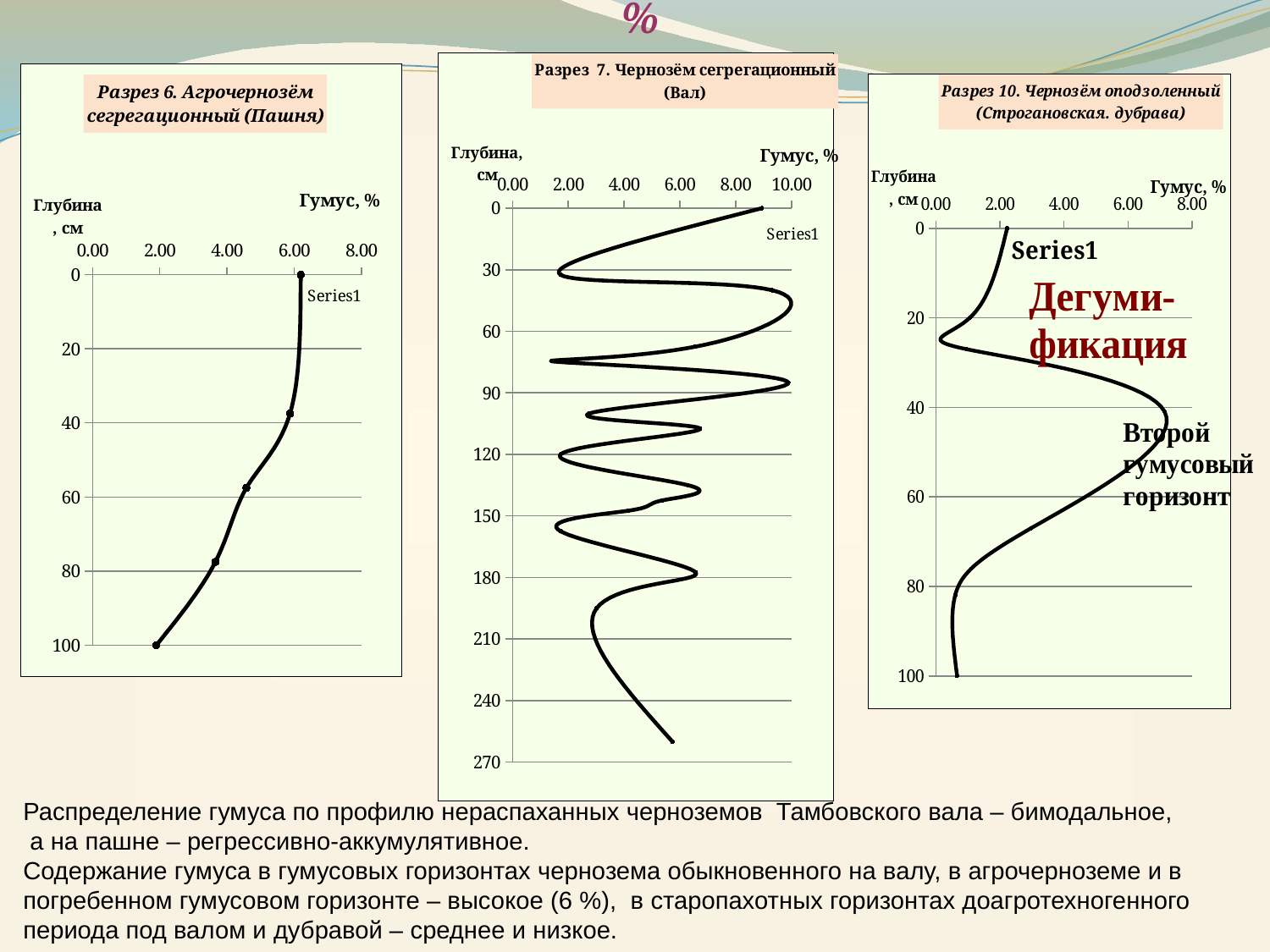
What is the label of the horizontal axis in the middle chart ("Разрез 7")? Гумус, % In the right chart ("Разрез 10"), is the humus value at depth 0 cm greater or less than 4.00? less In the middle chart ("Разрез 7"), is the humus value at depth 0 cm greater or less than 8.00? greater In the middle chart ("Разрез 7"), is the humus value at the deepest plotted point (about 260 cm) greater or less than 4.00? greater How many series does the legend of the middle chart ("Разрез 7. Чернозём сегрегационный (Вал)") list? 1 What is the legend entry shown in the right chart ("Разрез 10")? Series1 What kind of chart is the left chart titled "Разрез 6. Агрочернозём сегрегационный (Пашня)"? line chart In the left chart ("Разрез 6"), does the humus content rise or fall as depth increases from 0 to 100 cm? fall